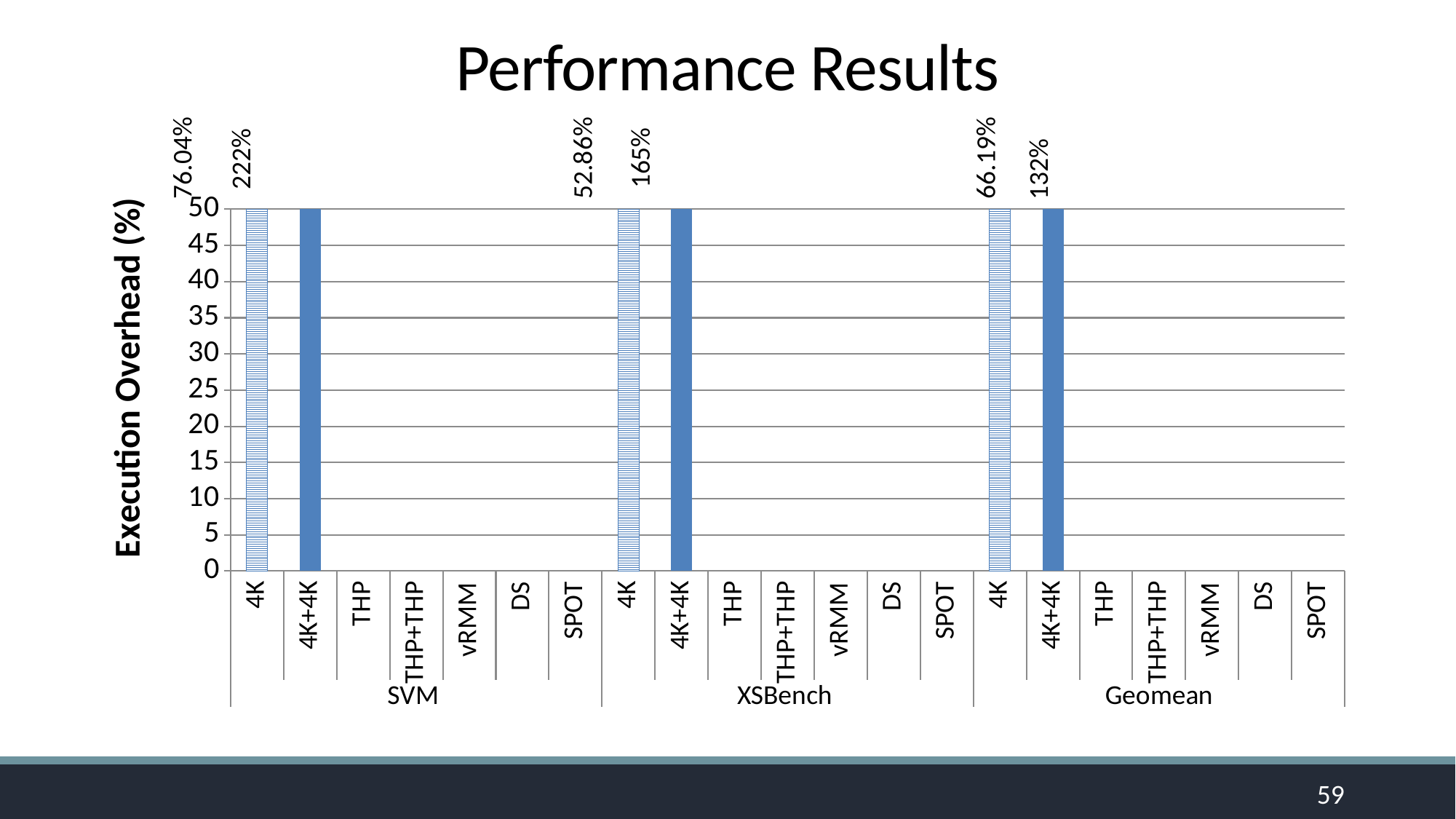
What is the label of the vertical axis? Execution Overhead (%) Which is larger, the 4K+4K value for SVM or the 4K+4K value for Geomean? SVM What is the title of the chart? Performance Results What kind of chart is shown on the slide? bar chart What is the execution overhead for the 4K+4K configuration in the Geomean group? 132% Is the value for 4K+4K in the Geomean group greater or less than 50? greater How many configurations are listed within each benchmark group on the x axis? 7 Which configuration has the highest execution overhead in the SVM group? 4K+4K Is the value for 4K in the XSBench group greater or less than 50? greater What is the execution overhead for the 4K configuration in the SVM group? 76.04% What is the execution overhead for the 4K+4K configuration in the SVM group? 222% How many benchmark groups are shown along the x axis? 3